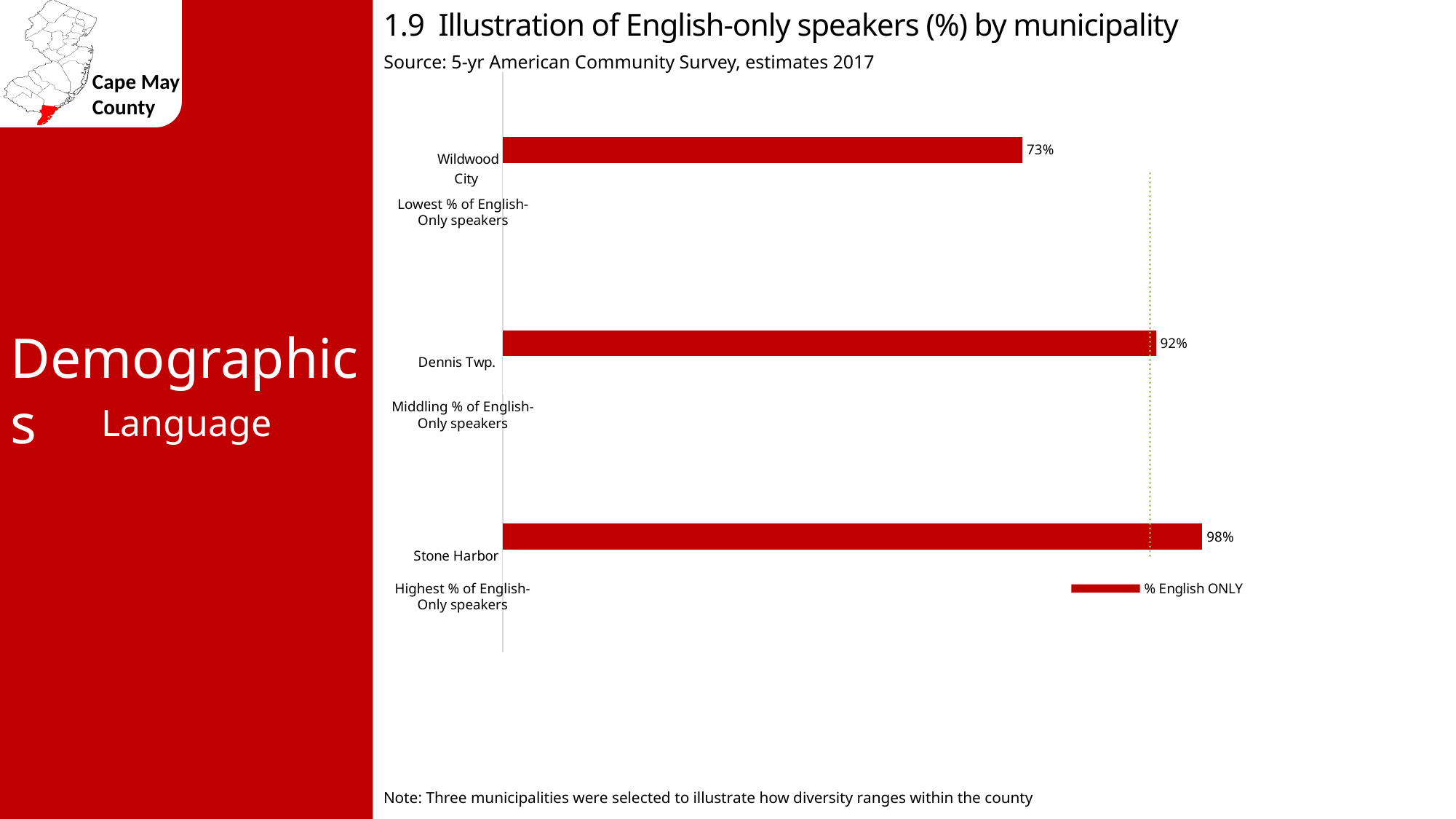
How many municipalities are shown in the chart? 3 Which municipality has the highest percentage of English-only speakers? Stone Harbor How many series does the legend list? 1 Which municipality has the lowest percentage of English-only speakers? Wildwood City Which has a higher percentage of English-only speakers, Dennis Twp. or Wildwood City? Dennis Twp. What is the percentage of English-only speakers in Wildwood City? 73% What is the difference in percentage points between Stone Harbor and Wildwood City? 25 What type of chart is shown on the slide? Bar chart What is the percentage of English-only speakers in Dennis Twp.? 92% What is the name of the series shown in the legend? % English ONLY What is the percentage of English-only speakers in Stone Harbor? 98% What is the difference in percentage points between Dennis Twp. and Wildwood City? 19